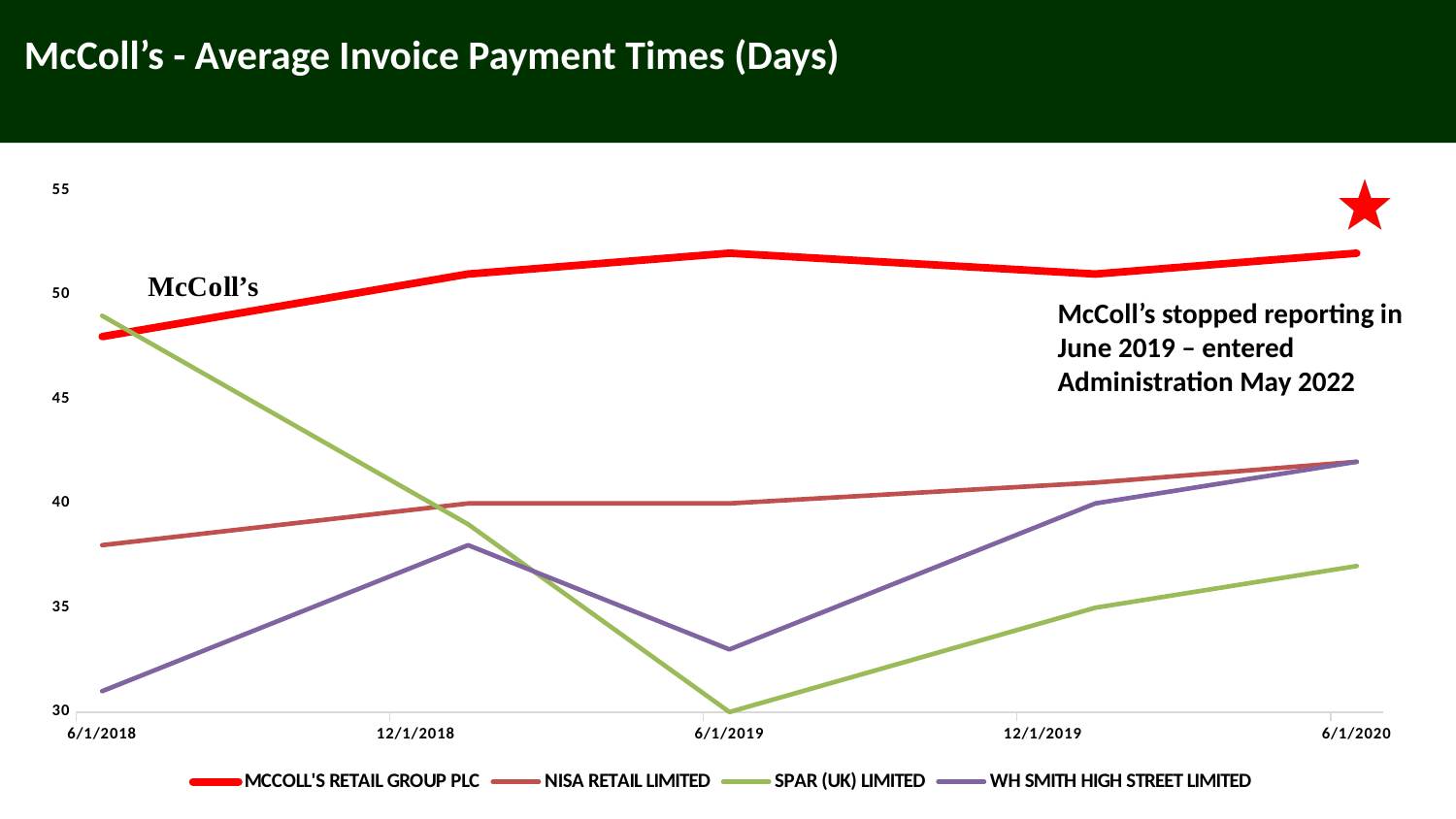
Is the value for WH SMITH HIGH STREET LIMITED at 6/1/2018 greater or less than 35? less How many series does the legend list? 4 Which series has the lowest value at 6/1/2018? WH SMITH HIGH STREET LIMITED Which series has the highest value at 6/1/2019? MCCOLL'S RETAIL GROUP PLC Does the NISA RETAIL LIMITED line rise or fall from 6/1/2018 to 6/1/2020? Rise What colour is the MCCOLL'S RETAIL GROUP PLC line? Red How many dates are labelled on the x axis? 5 At 12/1/2019, which is larger: WH SMITH HIGH STREET LIMITED or SPAR (UK) LIMITED? WH SMITH HIGH STREET LIMITED What kind of chart is shown on the slide? Line chart Does the SPAR (UK) LIMITED line rise or fall between 6/1/2018 and 6/1/2019? Fall Which series has the lowest value at 6/1/2019? SPAR (UK) LIMITED Is the value for MCCOLL'S RETAIL GROUP PLC at 6/1/2019 greater or less than 50? greater